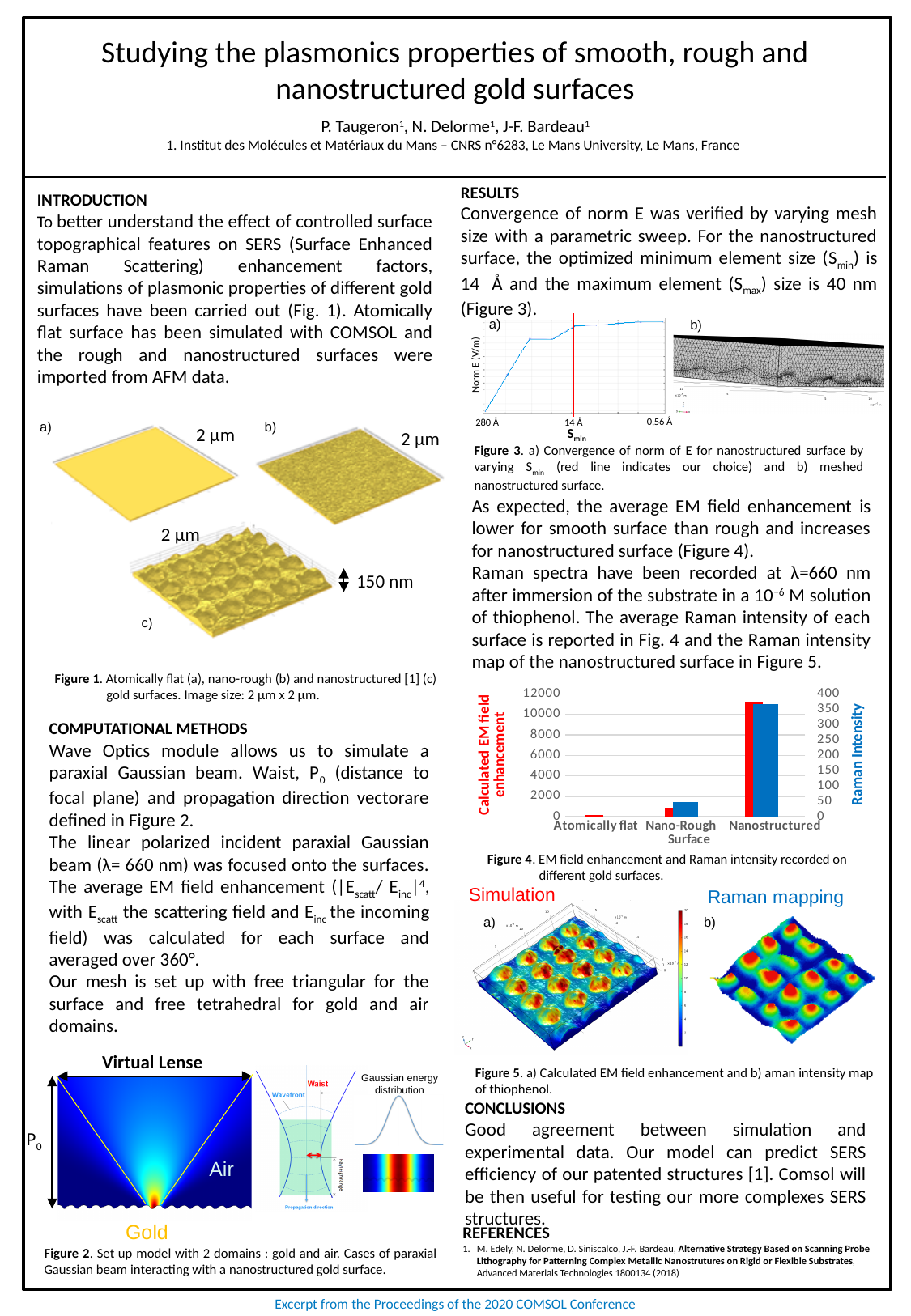
In Figure 4, is the calculated EM field enhancement for the Nano-Rough Surface greater or less than 2000? less In Figure 4, what is the label of the right-hand vertical axis? Raman Intensity In Figure 4, which has the larger calculated EM field enhancement, the Nano-Rough Surface or the Nanostructured surface? Nanostructured In Figure 4, is the calculated EM field enhancement for the Nanostructured surface greater or less than 10000? greater In Figure 4, which surface has the highest Raman intensity? Nanostructured In Figure 4, which surface has the lowest calculated EM field enhancement? Atomically flat In Figure 4, which surface has the highest calculated EM field enhancement? Nanostructured In Figure 4, how many gold surface categories are shown on the x axis? 3 In Figure 3a, does Norm E rise or fall along the x axis from 280 Å toward 0,56 Å? rise In Figure 4, what kind of chart is used to show EM field enhancement and Raman intensity? bar chart In Figure 4, is the Raman intensity for the Nanostructured surface greater or less than 300? greater In Figure 4, how many data series are plotted (one per axis)? 2